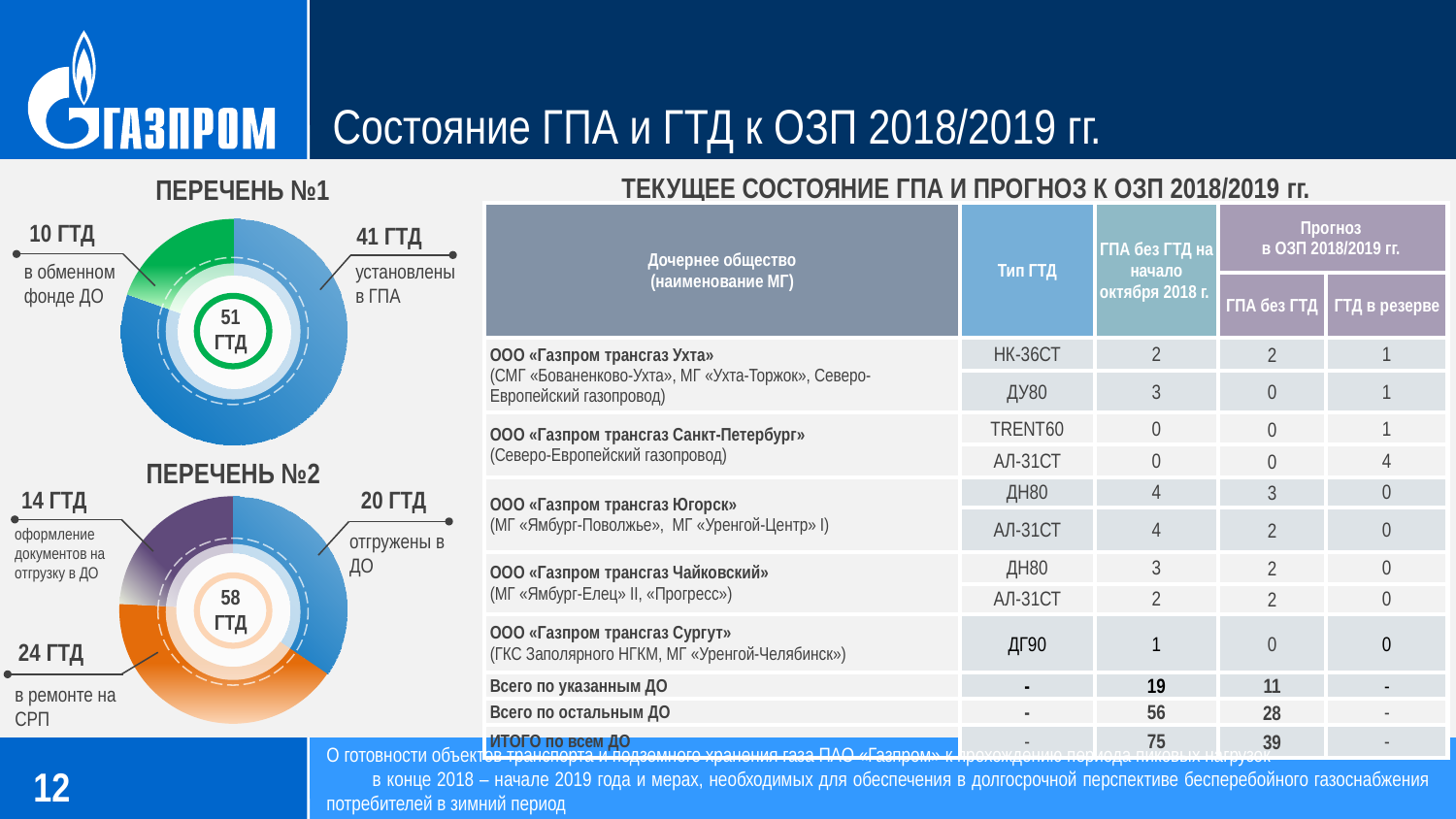
In the "ПЕРЕЧЕНЬ №2" chart, how many ГТД are in the category оформление документов на отгрузку в ДО? 14 ГТД In the "ПЕРЕЧЕНЬ №1" chart, what is the difference between the ГТД установлены в ГПА and the ГТД в обменном фонде ДО? 31 ГТД What total is shown in the centre of the "ПЕРЕЧЕНЬ №1" chart? 51 ГТД In the "ПЕРЕЧЕНЬ №2" chart, how many ГТД are в ремонте на СРП? 24 ГТД What total is shown in the centre of the "ПЕРЕЧЕНЬ №2" chart? 58 ГТД In the "ПЕРЕЧЕНЬ №2" chart, which category is the smallest? оформление документов на отгрузку в ДО In the "ПЕРЕЧЕНЬ №1" chart, how many ГТД are установлены в ГПА? 41 ГТД In the "ПЕРЕЧЕНЬ №2" chart, how many ГТД are отгружены в ДО? 20 ГТД In the "ПЕРЕЧЕНЬ №1" chart, how many ГТД are в обменном фонде ДО? 10 ГТД In the "ПЕРЕЧЕНЬ №1" chart, which category is the largest? установлены в ГПА What kind of chart is "ПЕРЕЧЕНЬ №1"? Donut (pie) chart How many categories does the "ПЕРЕЧЕНЬ №2" chart show? 3